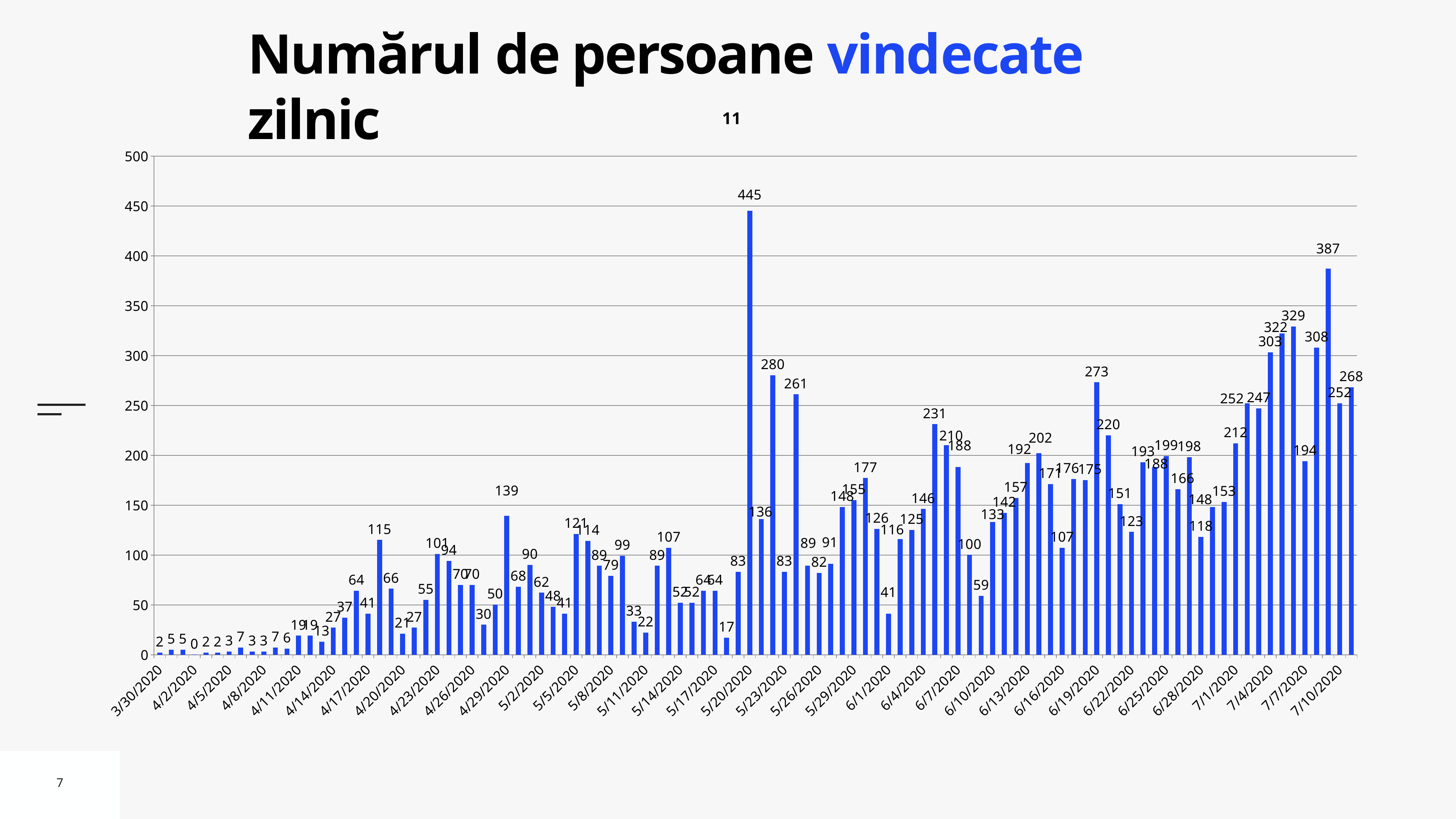
What is the value shown for 4/29/2020? 139 On which date does the chart show the highest number of recovered persons? 5/20/2020 Overall, do the values rise or fall from 3/30/2020 to 7/10/2020? rise What is the value shown for 5/29/2020? 155 What is the value shown for 7/10/2020? 252 What is the value shown for 5/20/2020? 445 Which date has the larger value, 6/7/2020 or 6/13/2020? 6/13/2020 Is the value for 7/4/2020 greater or less than 250? greater What is the value shown for 6/19/2020? 273 What is the value shown for 4/2/2020? 0 What kind of chart is shown on the slide? bar chart What is the difference between the values for 6/19/2020 and 6/1/2020? 232